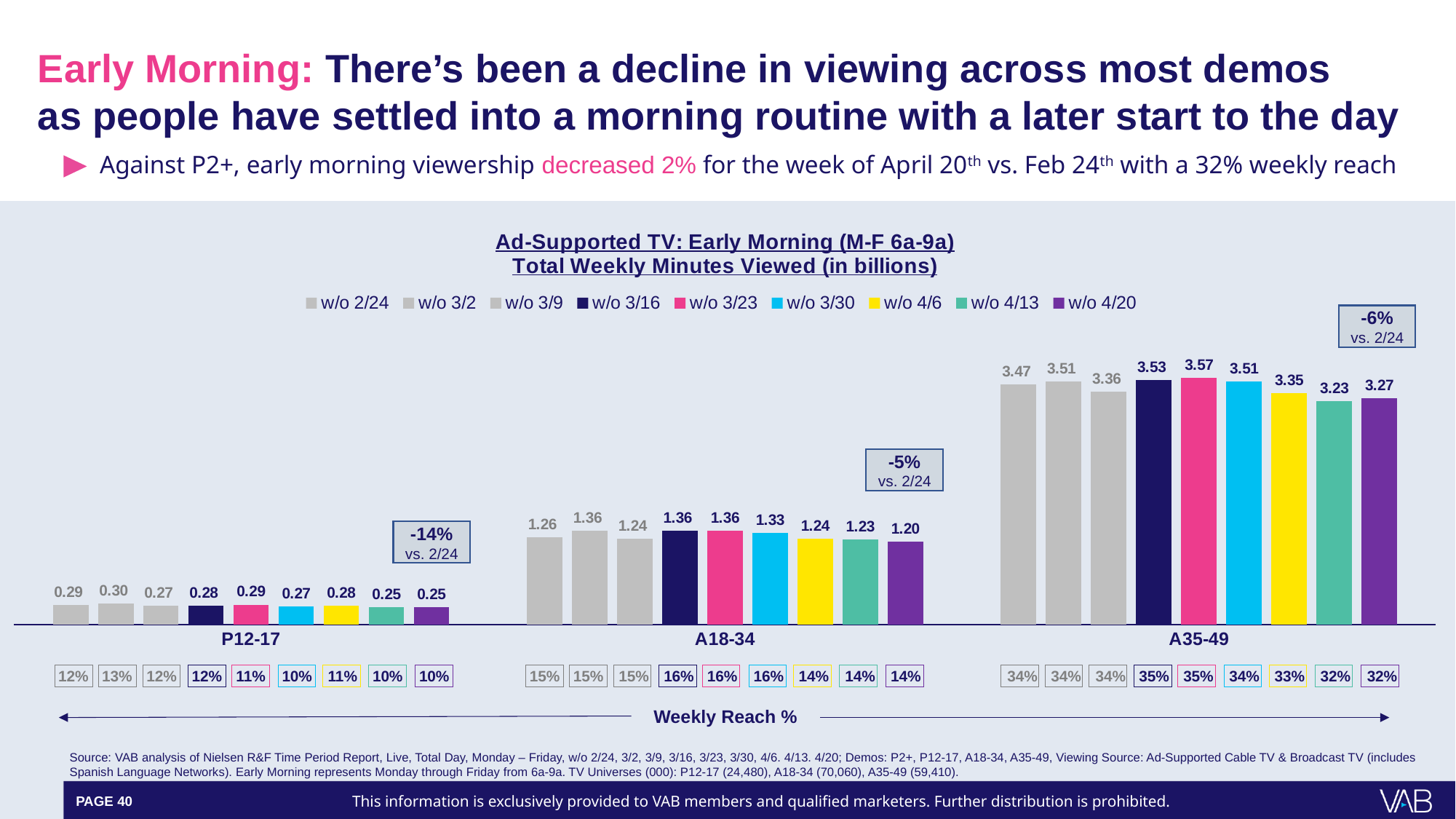
What is the value for P12-17 in w/o 3/2? 0.30 What kind of chart is shown on the slide? Bar chart For A35-49, do the values rise or fall from w/o 3/23 to w/o 4/13? Fall How many demo groups are shown on the x axis of the chart? 3 What is the value for A18-34 in w/o 2/24? 1.26 For A18-34, which is larger: the value for w/o 3/2 or the value for w/o 4/6? w/o 3/2 How many series does the legend list? 9 What percentage change vs. 2/24 is annotated above the P12-17 group? -14% For A35-49, which week has the highest total weekly minutes viewed? w/o 3/23 For A35-49, what is the difference between the w/o 2/24 value and the w/o 4/20 value? 0.20 For A18-34, which week has the lowest total weekly minutes viewed? w/o 4/20 What is the total weekly minutes viewed (in billions) for A35-49 in w/o 4/20? 3.27